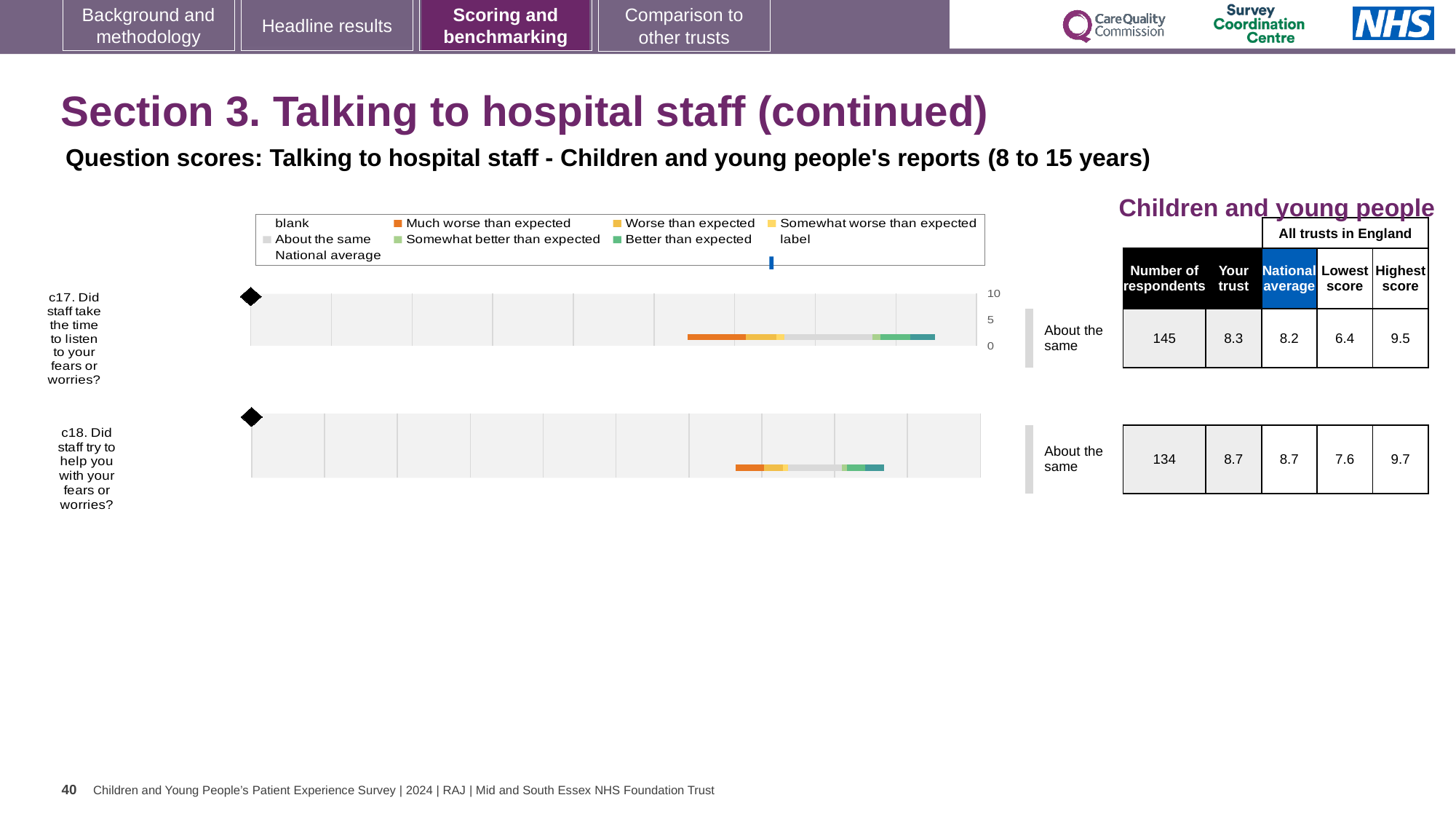
What is the national average score for question c17? 8.2 Which question has the higher 'Your trust' score, c17 or c18? c18 What is the 'Your trust' score for question c17 (Did staff take the time to listen to your fears or worries?)? 8.3 How many survey questions (bar rows) are plotted on the slide? 2 What is the difference between the highest score and the lowest score for question c17? 3.1 What is the difference between the 'Your trust' score and the national average for question c17? 0.1 How many entries does the chart legend list? 9 What benchmark category label is shown next to the bar for question c18? About the same What is the highest score among all trusts in England for question c18? 9.7 What is the number of respondents for question c18? 134 What is the 'Your trust' score for question c18 (Did staff try to help you with your fears or worries?)? 8.7 What kind of chart is used to show the question scores on this slide? bar chart